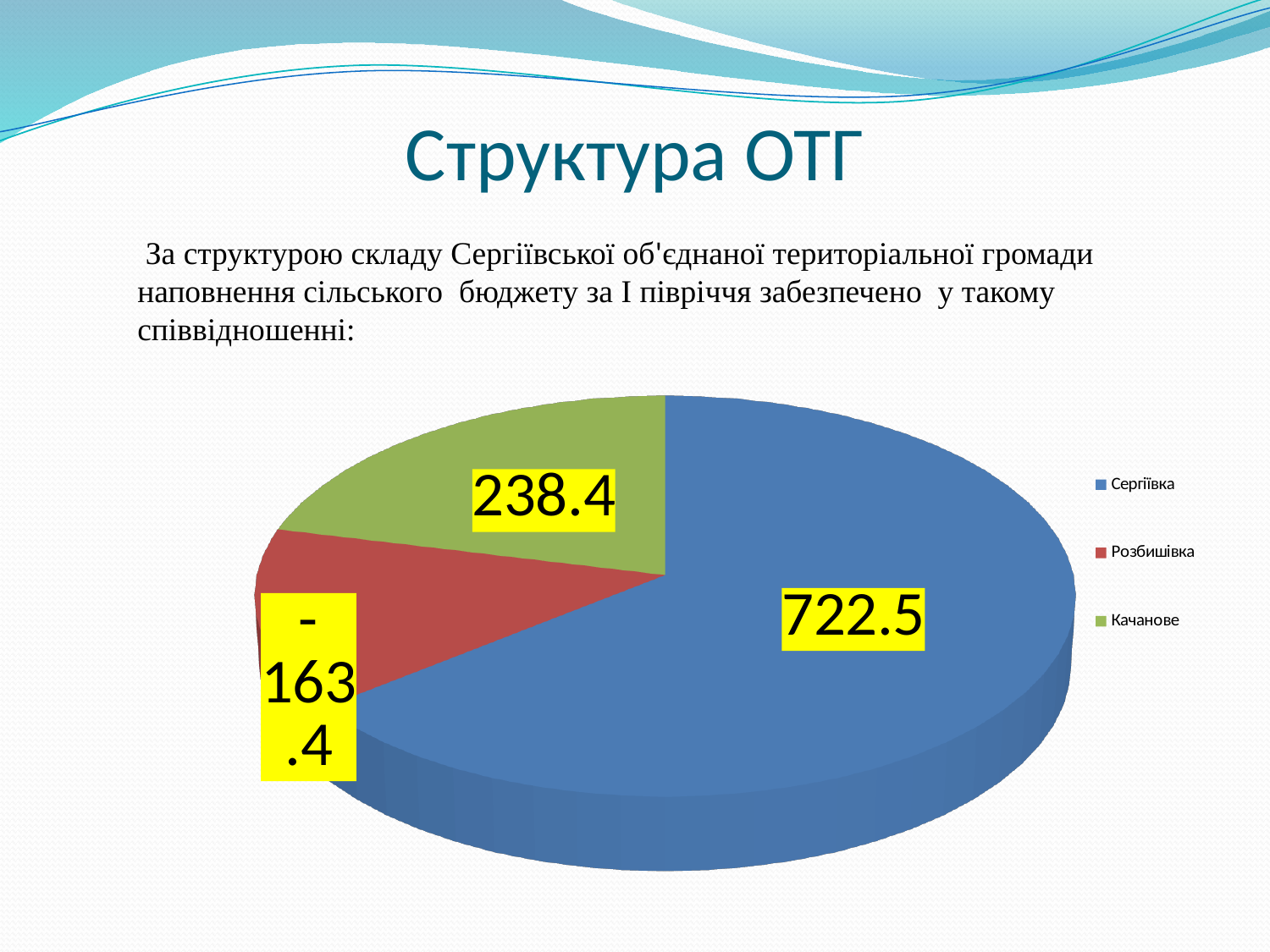
How many entries does the legend list? 3 What is the title of the slide containing the chart? Структура ОТГ What is the difference between the values for Сергіївка and Качанове? 484.1 What is the value shown for Качанове? 238.4 Which category has the smallest slice of the pie? Розбишівка Which category has the largest slice of the pie? Сергіївка Which is larger, the value for Качанове or the value for Розбишівка? Качанове What is the value shown for Розбишівка? -163.4 What colour is the slice for Качанове? green How many categories does the pie chart show? 3 What kind of chart is shown on the slide? pie chart What is the value shown for Сергіївка? 722.5